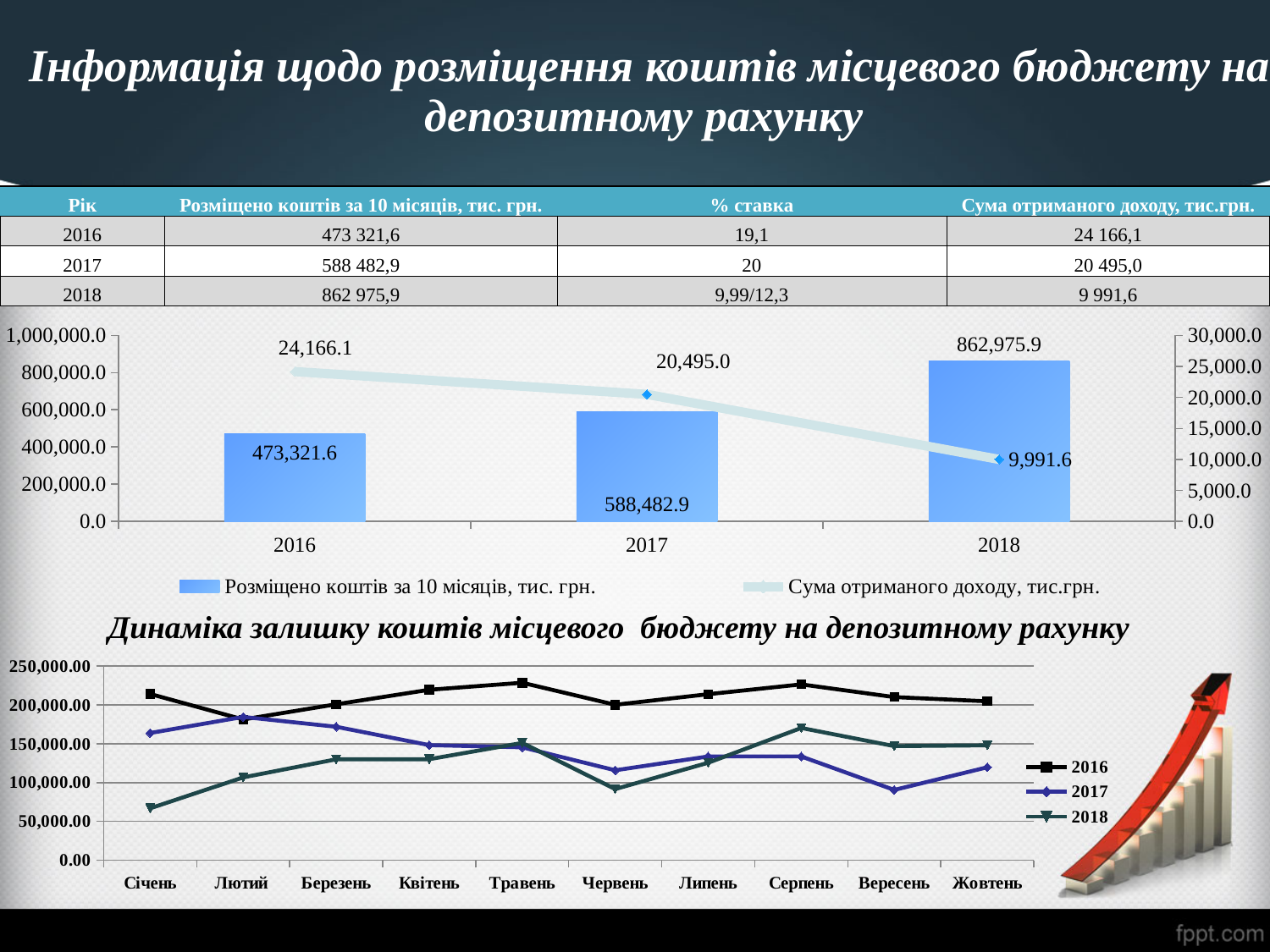
In the bottom chart, is the value for 2018 in Січень greater or less than 100,000.00? less In the top chart, what is the value of 'Сума отриманого доходу, тис.грн.' for 2017? 20,495.0 How many months are shown on the x axis of the bottom chart 'Динаміка залишку коштів місцевого бюджету на депозитному рахунку'? 10 How many series does the legend of the bottom chart 'Динаміка залишку коштів місцевого бюджету на депозитному рахунку' list? 3 What type of chart is the bottom chart 'Динаміка залишку коштів місцевого бюджету на депозитному рахунку'? line chart In the bottom chart, which series is higher in Травень: 2016 or 2018? 2016 In the top chart, which year has the lowest value of 'Сума отриманого доходу, тис.грн.'? 2018 In the top chart, does the 'Сума отриманого доходу, тис.грн.' line rise or fall from 2016 to 2018? fall In the top chart, what is the difference between the 'Сума отриманого доходу' values for 2016 and 2018? 14,174.5 In the top chart, what is the value of 'Розміщено коштів за 10 місяців, тис. грн.' for 2018? 862,975.9 In the top chart, what is the difference between the 'Розміщено коштів' values for 2018 and 2016? 389,654.3 In the top chart, which year has the highest bar for 'Розміщено коштів за 10 місяців, тис. грн.'? 2018